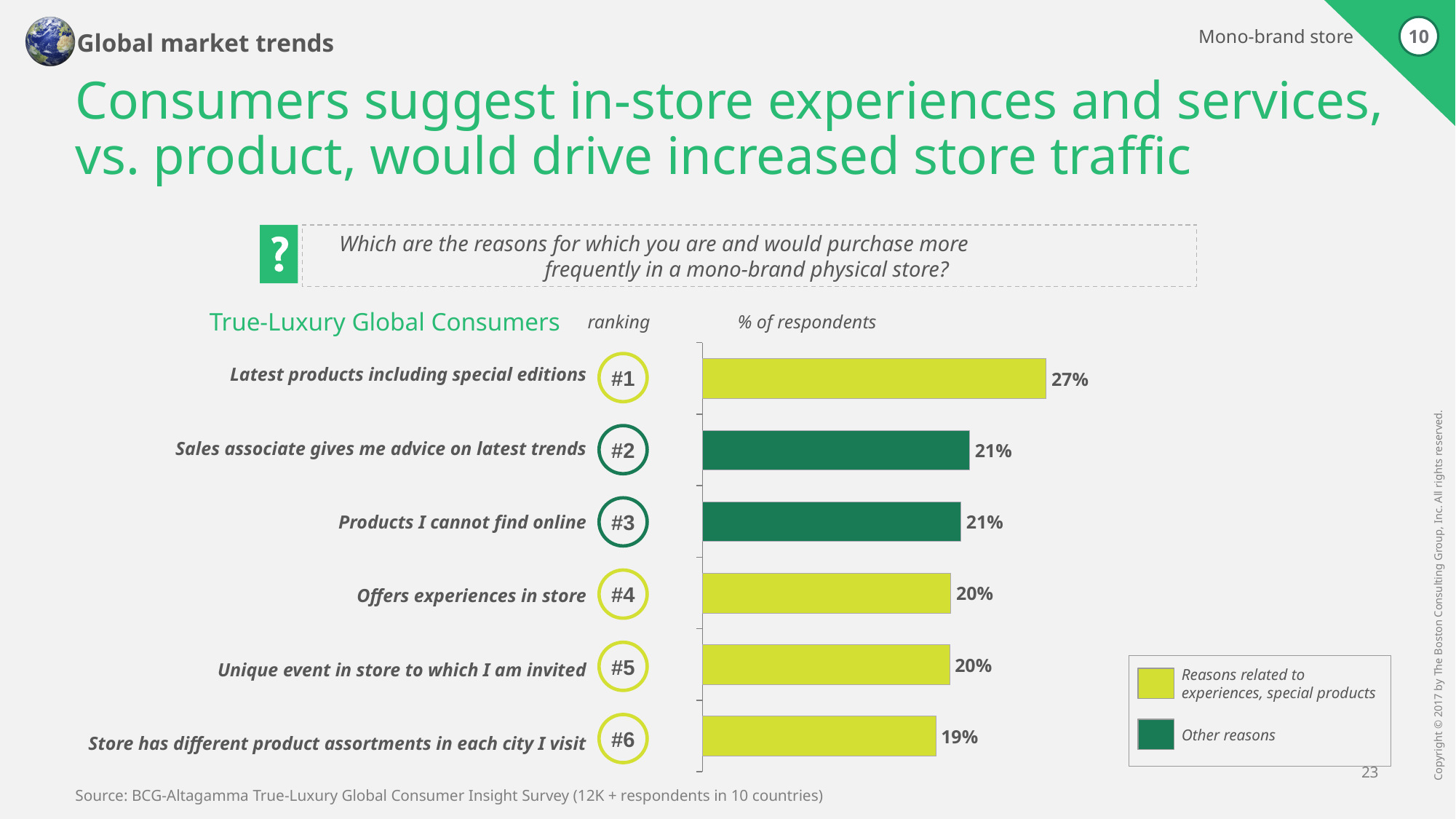
Which has a higher percentage of respondents: "Sales associate gives me advice on latest trends" or "Unique event in store to which I am invited"? Sales associate gives me advice on latest trends Which reason has the highest percentage of respondents? Latest products including special editions What percentage of respondents chose "Products I cannot find online"? 21% Which legend category do the dark green bars represent? Other reasons How many reasons are plotted in the chart? 6 What percentage of respondents chose "Offers experiences in store"? 20% What percentage of respondents chose "Store has different product assortments in each city I visit"? 19% What type of chart is shown on the slide? Bar chart What percentage of respondents chose "Latest products including special editions"? 27% Which reason has the lowest percentage of respondents? Store has different product assortments in each city I visit How many categories does the legend list? 2 What is the difference in percentage points between "Latest products including special editions" and "Sales associate gives me advice on latest trends"? 6 percentage points